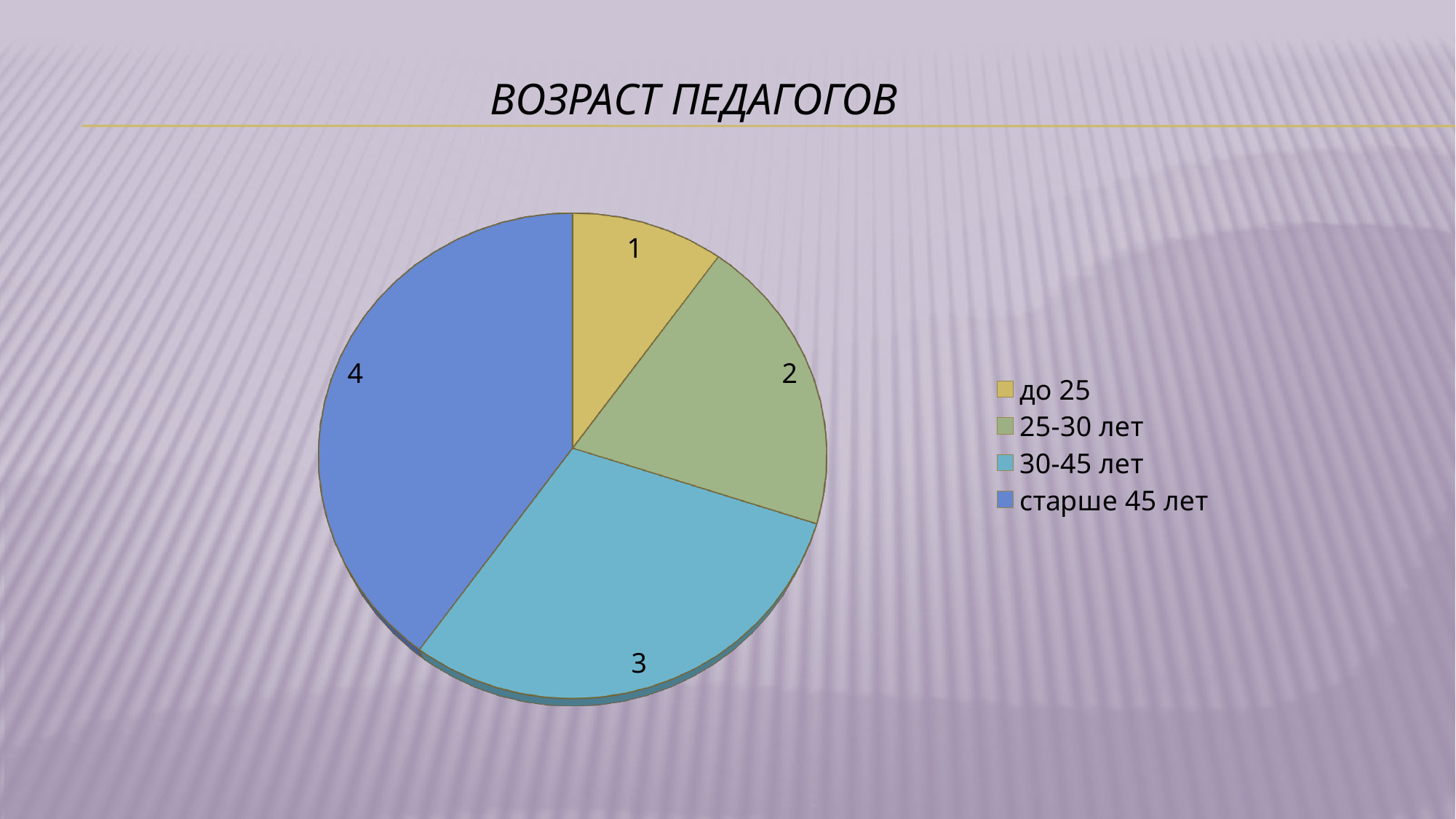
Which age group has the smallest slice? до 25 What kind of chart is shown on the slide? pie chart What share of the pie does the '30-45 лет' slice represent? 30% What is the value for the '25-30 лет' slice? 2 What is the value for the 'старше 45 лет' slice? 4 What is the title of the chart? ВОЗРАСТ ПЕДАГОГОВ What is the value for the '30-45 лет' slice? 3 What is the difference between the values for 'старше 45 лет' and 'до 25'? 3 Which age group has the largest slice? старше 45 лет How many slices does the pie chart have? 4 How many entries does the legend list? 4 What is the value for the 'до 25' slice? 1